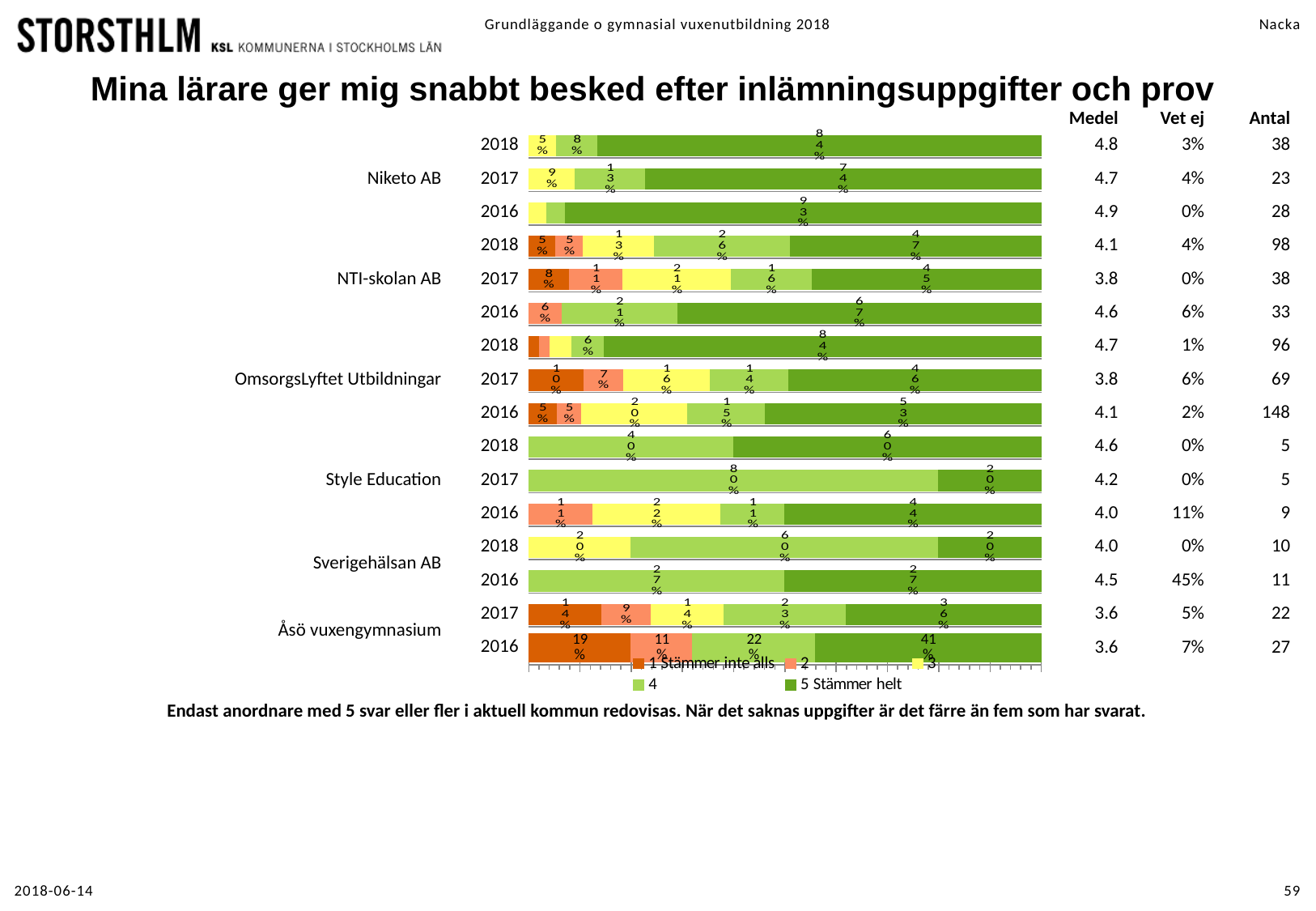
What is the share of '4' for Sverigehälsan AB in 2018? 60% For Åsö vuxengymnasium 2016, what is the difference between the '5 Stämmer helt' share and the '1 Stämmer inte alls' share? 22 percentage points How many bars (provider-year rows) are plotted in the chart? 16 How many series does the chart legend list? 5 What is the share of '1 Stämmer inte alls' for Åsö vuxengymnasium in 2016? 19% What is the legend label for the darkest green series? 5 Stämmer helt Which bar has the highest share of '5 Stämmer helt'? Niketo AB 2016 What is the title of the chart? Mina lärare ger mig snabbt besked efter inlämningsuppgifter och prov What is the share of '4' for Style Education in 2017? 80% What is the share of '5 Stämmer helt' for Niketo AB in 2016? 93% Which has a larger share of '5 Stämmer helt': Niketo AB 2018 or NTI-skolan AB 2018? Niketo AB 2018 What kind of chart is shown on the slide? Stacked bar chart